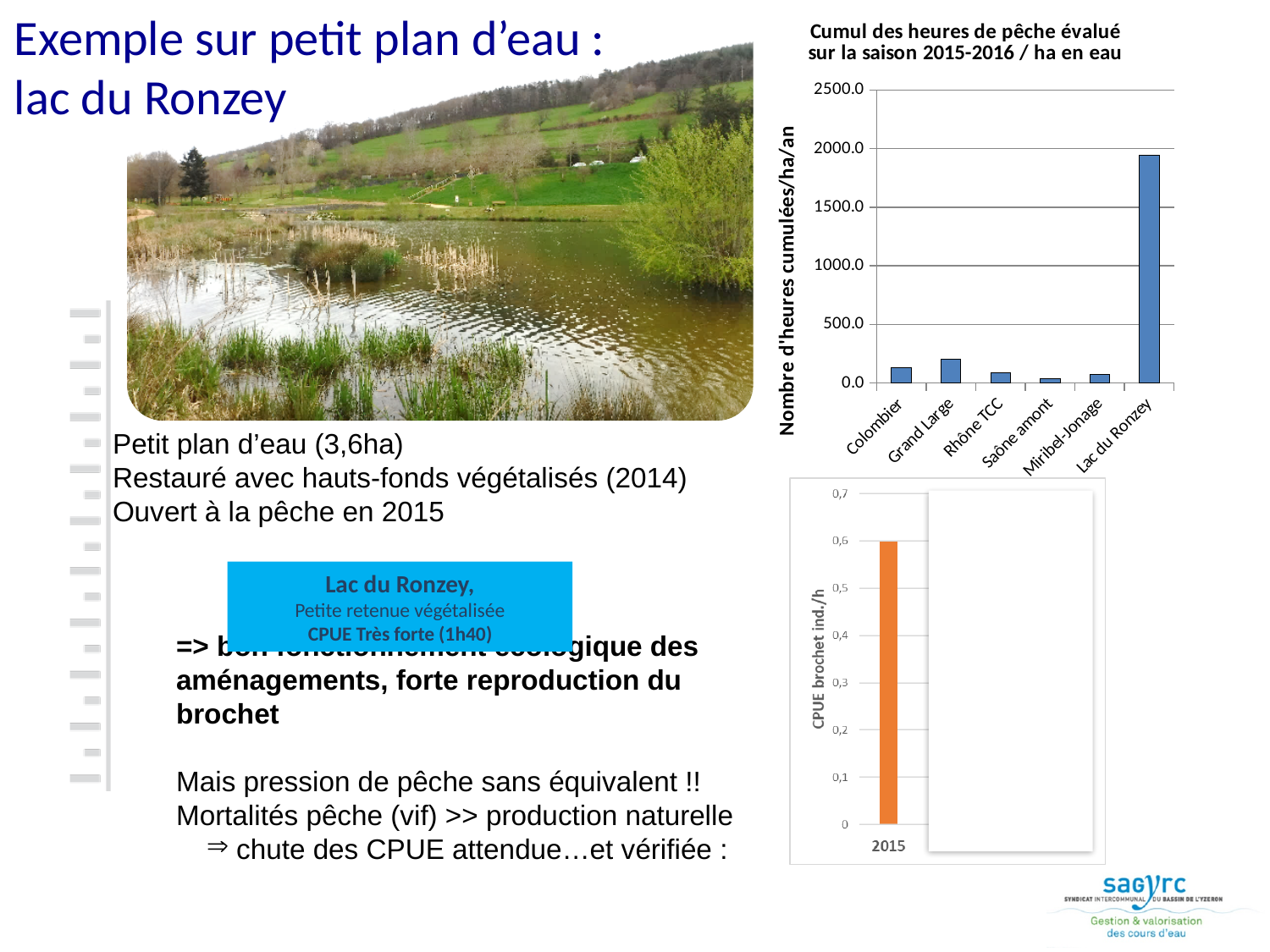
In the CPUE brochet chart at the bottom right, how many bars are plotted? 1 In the 'Cumul des heures de pêche évalué' chart, is the value for Grand Large greater or less than 500.0? less In the 'Cumul des heures de pêche évalué' chart, which site has the highest value? Lac du Ronzey In the CPUE brochet chart at the bottom right, is the value for 2015 greater or less than 0,5? greater In the 'Cumul des heures de pêche évalué' chart, is the value for Lac du Ronzey greater or less than 1500.0? greater In the 'Cumul des heures de pêche évalué' chart, which is larger, the value for Grand Large or the value for Colombier? Grand Large What is the y-axis label of the 'Cumul des heures de pêche évalué' chart? Nombre d'heures cumulées/ha/an What is the y-axis label of the chart at the bottom right? CPUE brochet ind./h In the 'Cumul des heures de pêche évalué' chart, how many sites are shown on the x axis? 6 What kind of chart is the 'Cumul des heures de pêche évalué' chart at the top right? bar chart In the 'Cumul des heures de pêche évalué' chart, which is larger, the value for Lac du Ronzey or the value for Miribel-Jonage? Lac du Ronzey In the 'Cumul des heures de pêche évalué' chart, which site has the lowest value? Saône amont